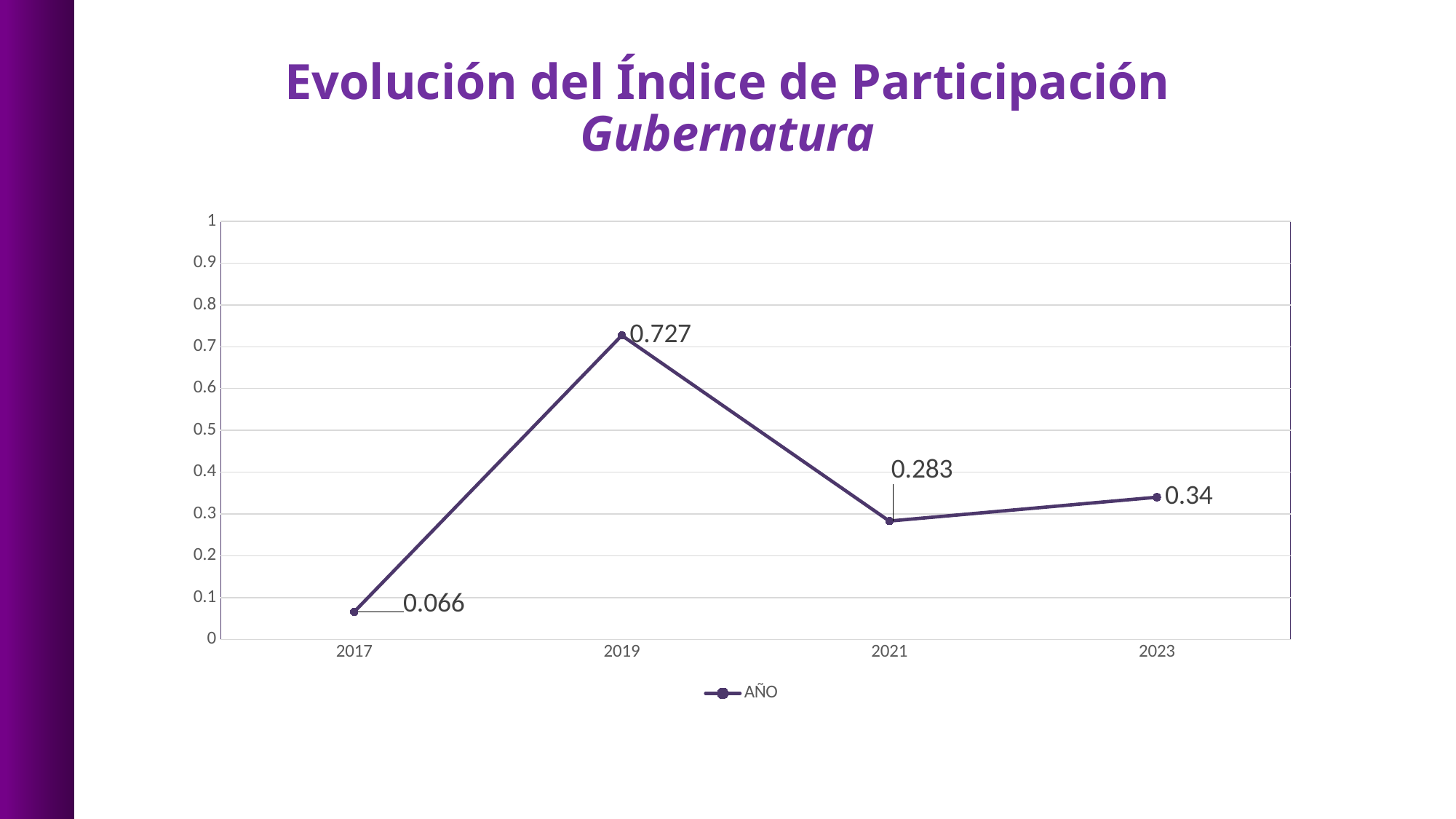
Which year has the highest value? 2019 What is the difference between the values for 2019 and 2021? 0.444 What is the legend entry for the plotted series? AÑO What is the value for 2017? 0.066 Which is larger, the value for 2021 or the value for 2023? 2023 How many years are plotted on the chart? 4 What is the value for 2019? 0.727 Is the value for 2019 greater or less than 0.5? greater What is the value for 2021? 0.283 What is the value for 2023? 0.34 What kind of chart is shown? line chart Which year has the lowest value? 2017